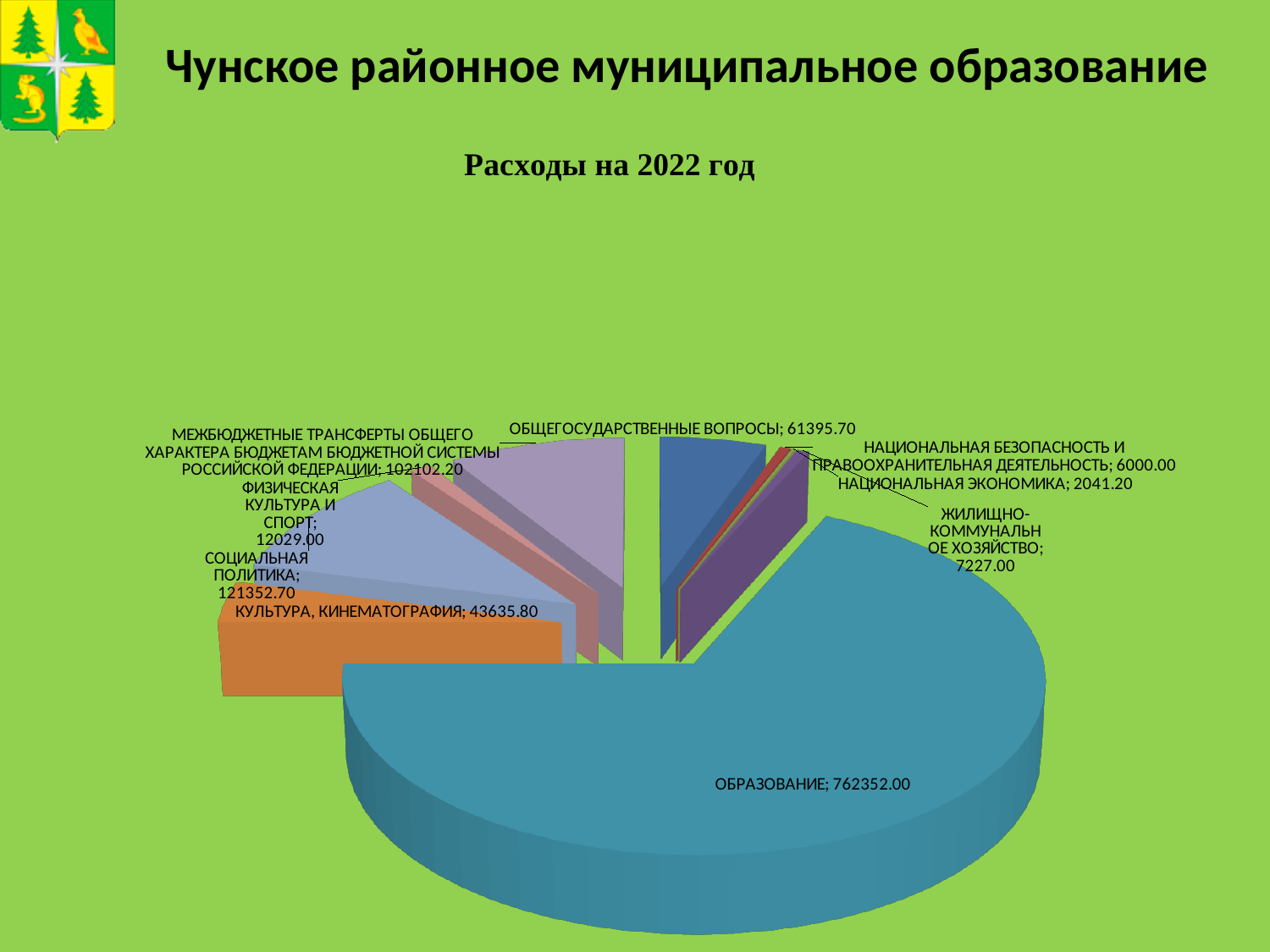
What is the difference between the values for ОБЩЕГОСУДАРСТВЕННЫЕ ВОПРОСЫ and КУЛЬТУРА, КИНЕМАТОГРАФИЯ? 17759.90 Which category has the largest value? ОБРАЗОВАНИЕ How many categories (slices) does the pie chart show? 9 What is the title of the chart? Расходы на 2022 год Which is larger: СОЦИАЛЬНАЯ ПОЛИТИКА or МЕЖБЮДЖЕТНЫЕ ТРАНСФЕРТЫ ОБЩЕГО ХАРАКТЕРА БЮДЖЕТАМ БЮДЖЕТНОЙ СИСТЕМЫ РОССИЙСКОЙ ФЕДЕРАЦИИ? СОЦИАЛЬНАЯ ПОЛИТИКА What type of chart is shown on the slide? pie chart Which category has the smallest value? НАЦИОНАЛЬНАЯ ЭКОНОМИКА What is the value for ОБРАЗОВАНИЕ? 762352.00 What is the value for СОЦИАЛЬНАЯ ПОЛИТИКА? 121352.70 What is the difference between the values for ЖИЛИЩНО-КОММУНАЛЬНОЕ ХОЗЯЙСТВО and НАЦИОНАЛЬНАЯ БЕЗОПАСНОСТЬ И ПРАВООХРАНИТЕЛЬНАЯ ДЕЯТЕЛЬНОСТЬ? 1227.00 What is the value for КУЛЬТУРА, КИНЕМАТОГРАФИЯ? 43635.80 What is the value for НАЦИОНАЛЬНАЯ ЭКОНОМИКА? 2041.20